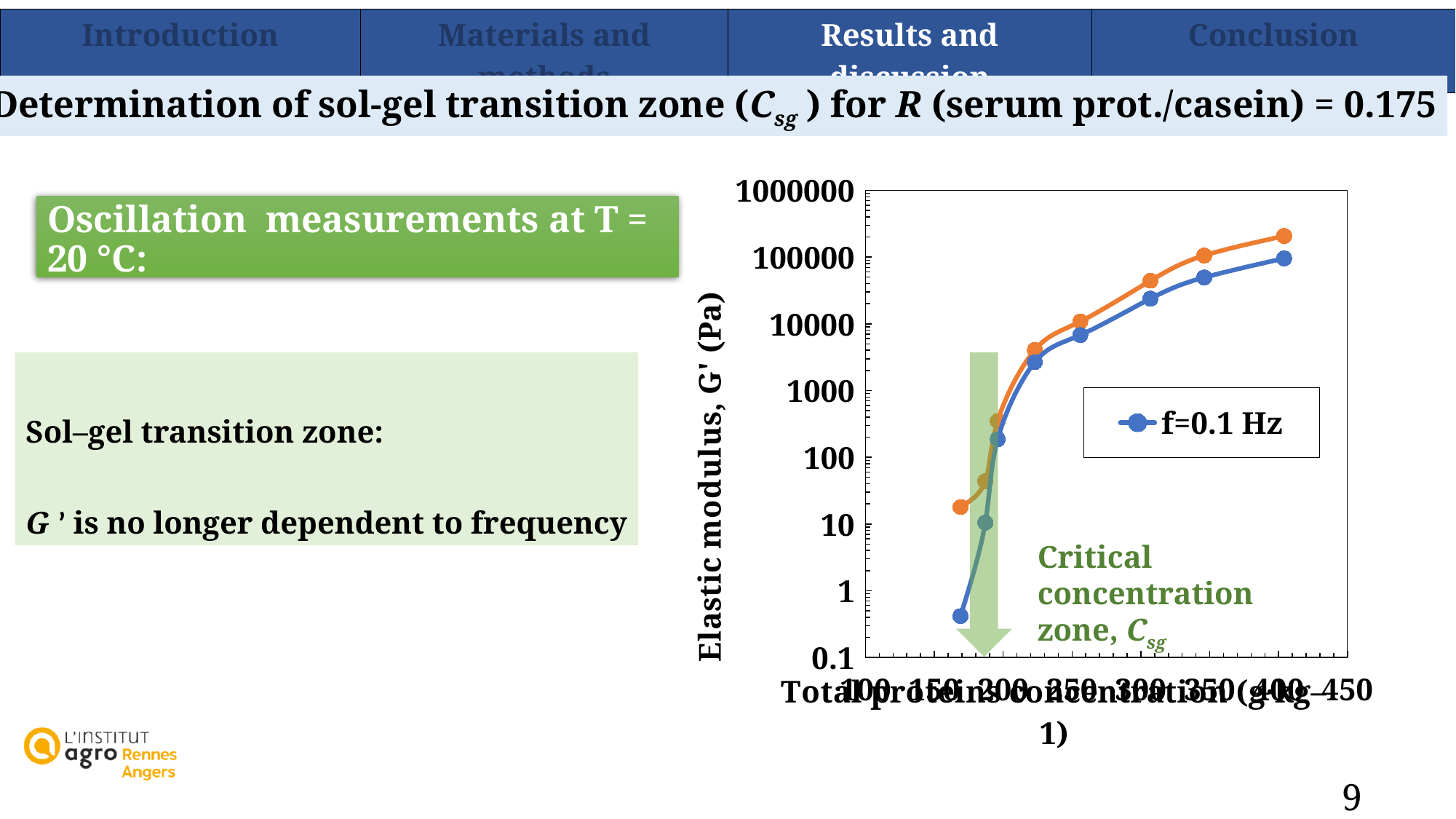
Is the value of the leftmost point of the orange series greater or less than 10? greater How many series does the chart legend list? 1 At the rightmost data point, which series has the larger value, the orange series or the blue f=0.1 Hz series? orange series Which point of the blue f=0.1 Hz series has the lowest value, the leftmost or the rightmost? leftmost Is the value of the rightmost point of the blue f=0.1 Hz series greater or less than 10000? greater Does the elastic modulus G' rise or fall as total protein concentration increases along the x axis? rise What is the series name shown in the chart legend? f=0.1 Hz What is the highest tick value shown on the y axis of the chart? 1000000 Is the value of the leftmost point of the blue f=0.1 Hz series greater or less than 1? less How many data points does the blue f=0.1 Hz series have? 8 What kind of chart is shown on the slide? line chart